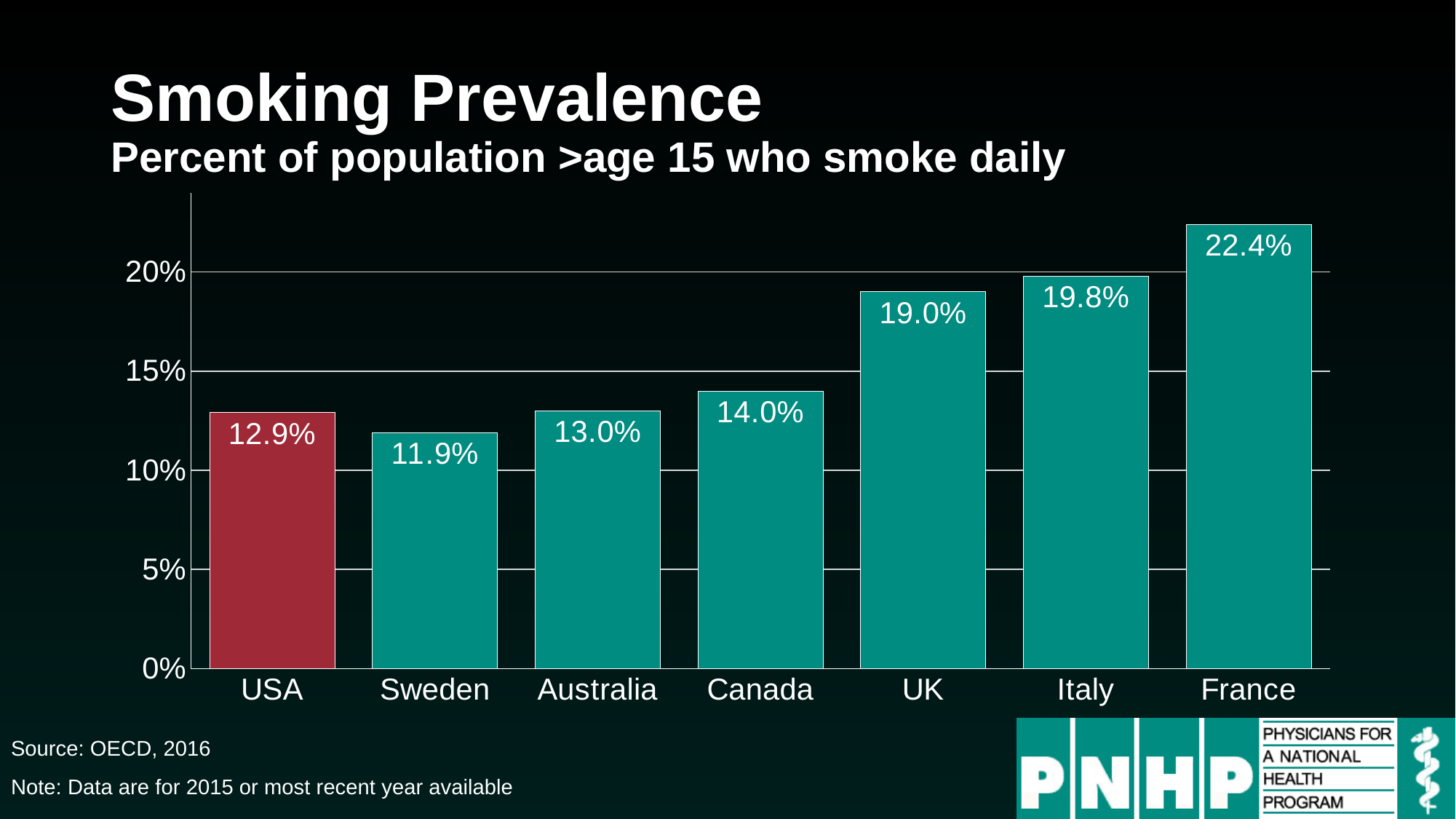
What is the difference between the values for Italy and the UK? 0.8% Which country has the lowest smoking prevalence on the chart? Sweden Which country has the highest smoking prevalence on the chart? France Which bar is shown in a different colour (red) from the others? USA Which has a higher value, Canada or Australia? Canada What is the value shown for Sweden? 11.9% What is the value shown for France? 22.4% What is the smoking prevalence value shown for the USA? 12.9% How many countries are shown on the chart? 7 Is the value for the UK greater or less than 20%? less What kind of chart is shown on the slide? Bar chart What is the difference between the values for France and the USA? 9.5%